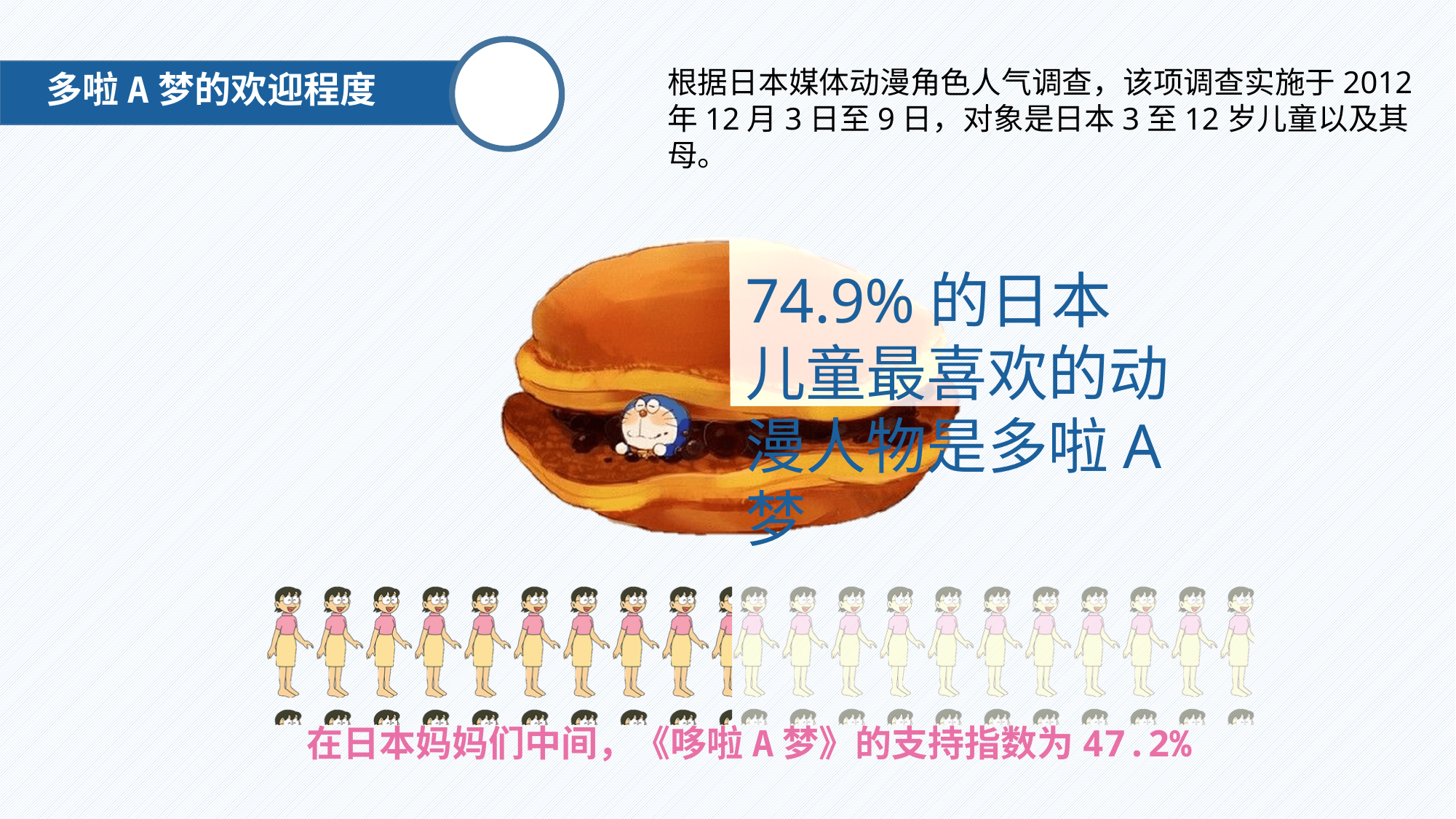
Is the share of Japanese children who favour Doraemon greater or less than 70%? greater What is the title shown in the blue banner at the top left of the slide? 多啦A梦的欢迎程度 What kind of chart is used at the bottom of the slide to show the mothers' support index? pictogram (pictograph of repeated figures) According to the slide, what percentage of Japanese children chose Doraemon as their favourite anime character? 74.9% What is the support index for Doraemon among Japanese mothers shown below the pictogram? 47.2% Which is larger: the share of Japanese children who favour Doraemon or the support index among Japanese mothers? Japanese children (74.9%) Is the support index among Japanese mothers greater or less than 50%? less In what year was the survey cited on the slide conducted? 2012 What is the difference between the children's figure (74.9%) and the mothers' support index (47.2%)? 27.7%